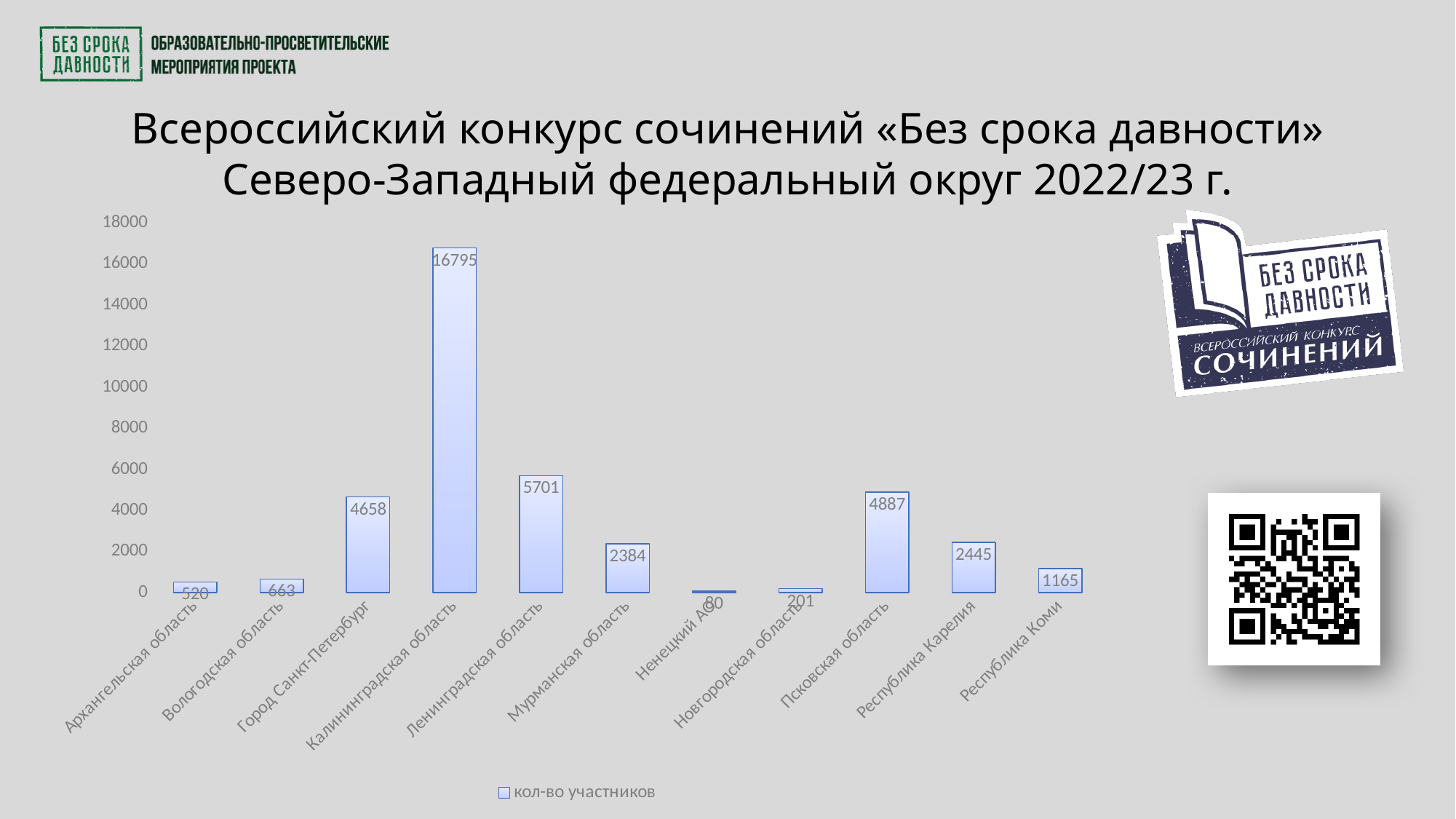
Which region has the highest number of participants? Калининградская область What is the value for Республика Коми? 1165 How many participants are shown for Калининградская область? 16795 Which region has the lowest number of participants? Ненецкий АО What series name does the legend show? кол-во участников What is the value for Город Санкт-Петербург? 4658 How many regions are shown on the x axis of the chart? 11 What is the value for Ленинградская область? 5701 What type of chart is shown on the slide? bar chart Which is larger, the value for Мурманская область or the value for Республика Карелия? Республика Карелия What is the difference between the values for Псковская область and Город Санкт-Петербург? 229 Is the value for Ленинградская область greater or less than 6000? less